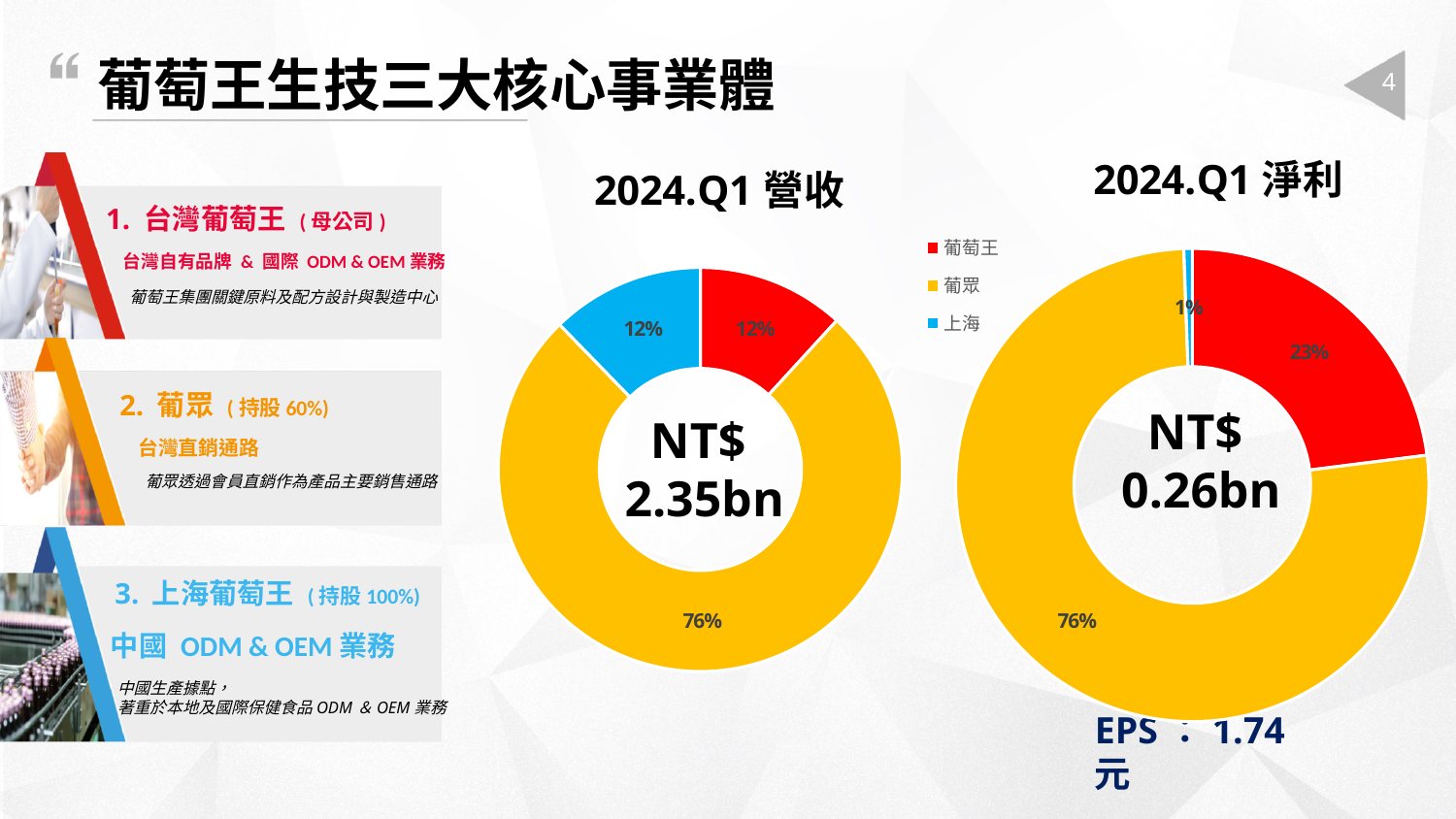
In the 2024.Q1 淨利 chart, what share does 葡萄王 hold? 23% In the 2024.Q1 營收 chart, what share does 葡眾 hold? 76% How many series does the legend list? 3 In the 2024.Q1 淨利 chart, which segment is the smallest? 上海 What kind of chart is the 2024.Q1 淨利 chart? Donut (pie) chart In the 2024.Q1 營收 chart, what share does 葡萄王 hold? 12% In the 2024.Q1 淨利 chart, which segment is the largest? 葡眾 How many segments does the 2024.Q1 營收 chart have? 3 What total value is shown in the centre of the 2024.Q1 營收 chart? NT$ 2.35bn In the 2024.Q1 淨利 chart, what share does 上海 hold? 1% In the 2024.Q1 淨利 chart, what is the difference in percentage points between 葡眾 and 葡萄王? 53 In the 2024.Q1 營收 chart, which is larger, the share of 葡眾 or the share of 上海? 葡眾